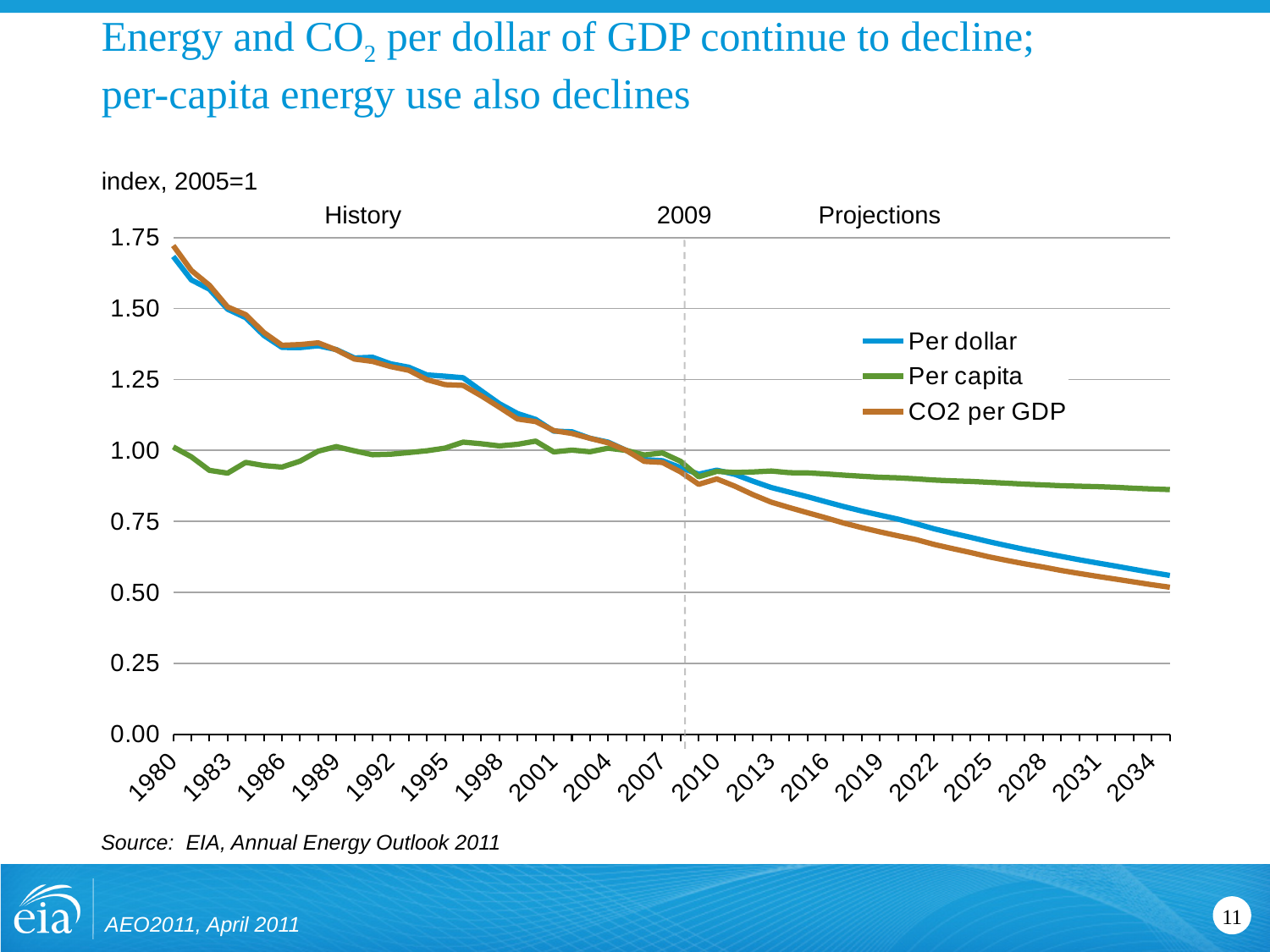
What kind of chart is shown on the slide? line chart In 1980, which is larger: Per dollar or Per capita? Per dollar In 2035, which is larger: Per capita or Per dollar? Per capita What year does the dashed vertical line separating History from Projections mark? 2009 How many series does the legend list? 3 Is the value for Per dollar in 2035 greater or less than 0.75? less Which series are listed in the legend? Per dollar, Per capita, CO2 per GDP Is the value for Per dollar in 1980 greater or less than 1.50? greater Is the value for Per capita in 1980 greater or less than 1.25? less Does the Per dollar series rise or fall from 1980 to 2035? fall